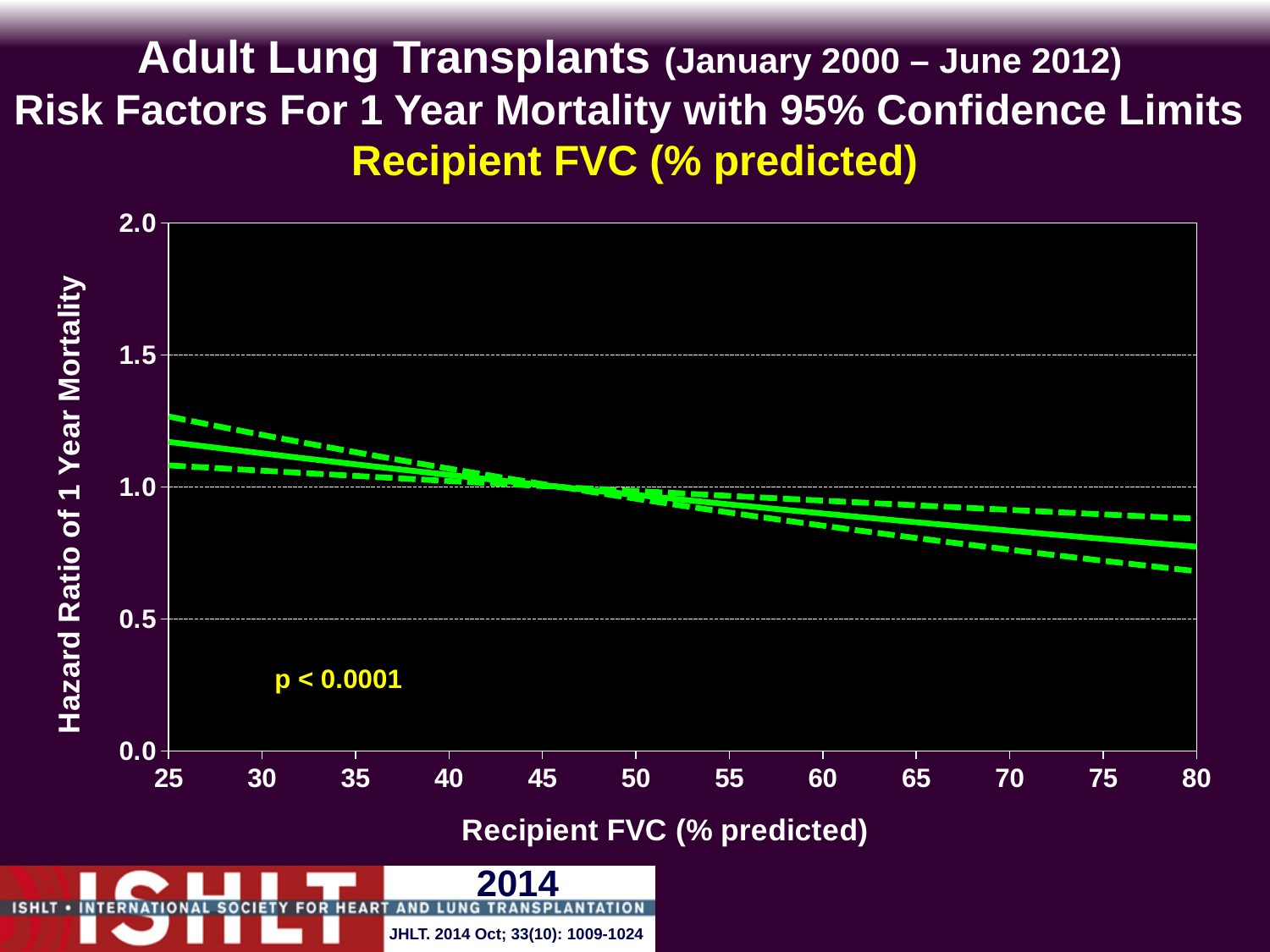
What kind of chart is shown on the slide? line chart What is the label of the y axis? Hazard Ratio of 1 Year Mortality Does the hazard ratio of 1 year mortality rise or fall as recipient FVC (% predicted) increases from 25 to 80? fall Is the upper 95% confidence limit at a recipient FVC of 80% predicted greater or less than 1.0? less Is the lower 95% confidence limit at a recipient FVC of 80% predicted greater or less than 0.5? greater Is the hazard ratio of 1 year mortality at a recipient FVC of 80% predicted greater or less than 1.0? less What p-value is printed on the chart? p < 0.0001 At which recipient FVC value shown on the x axis, 25 or 80, is the hazard ratio of 1 year mortality higher? 25 How many lines (solid and dashed) are plotted on the chart? 3 What is the highest value shown on the y axis? 2.0